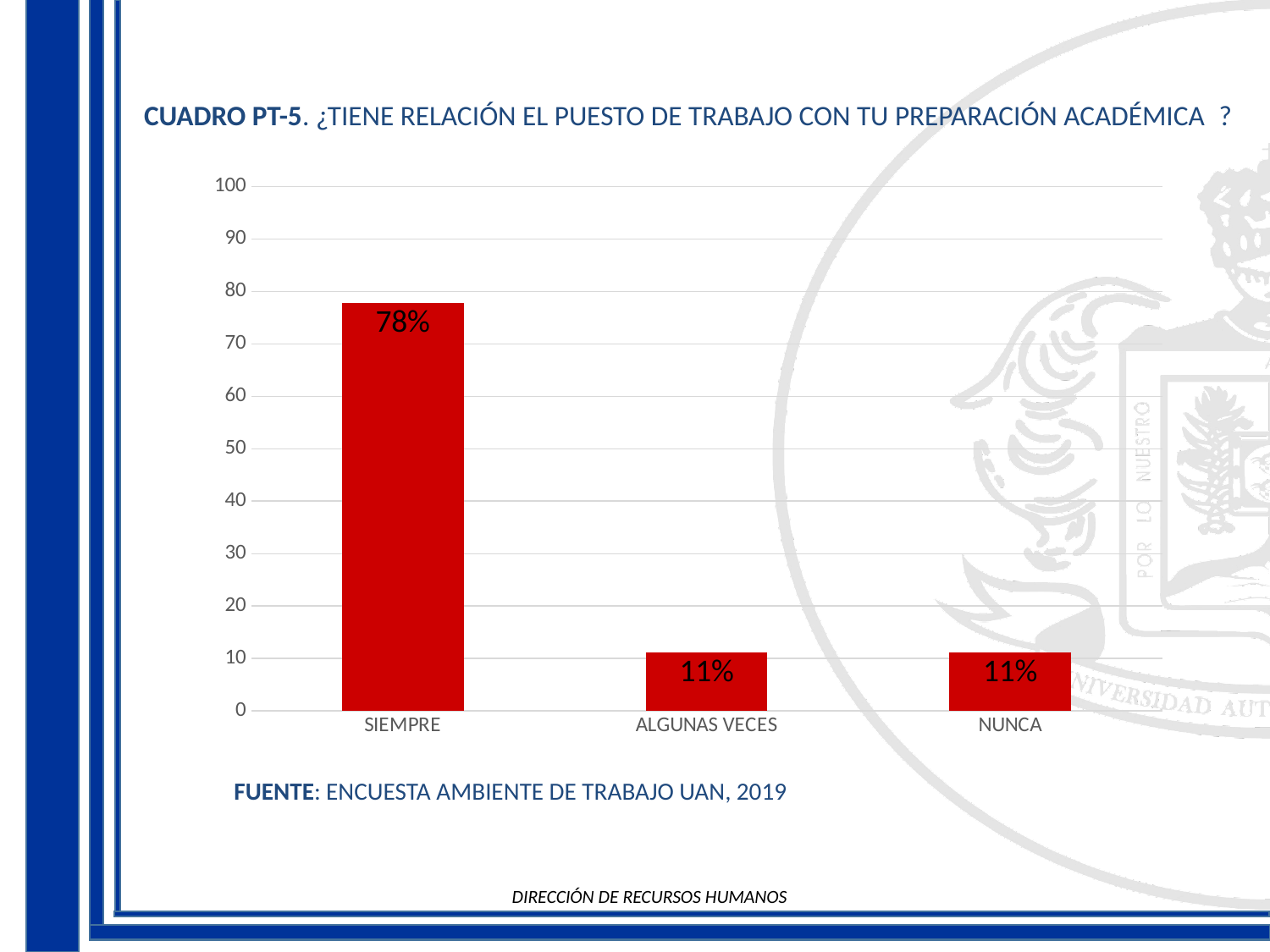
What is the value for ALGUNAS VECES? 11% What is the source cited below the chart? ENCUESTA AMBIENTE DE TRABAJO UAN, 2019 What is the value for NUNCA? 11% What is the value for SIEMPRE? 78% What colour are the bars in the chart? red Is the value for SIEMPRE greater or less than 70? greater What kind of chart is shown on the slide? bar chart Which is larger, the value for SIEMPRE or the value for NUNCA? SIEMPRE Which category has the highest value? SIEMPRE How many categories are shown on the x axis? 3 What is the difference between the values for SIEMPRE and ALGUNAS VECES? 67% Is the value for NUNCA greater or less than 20? less